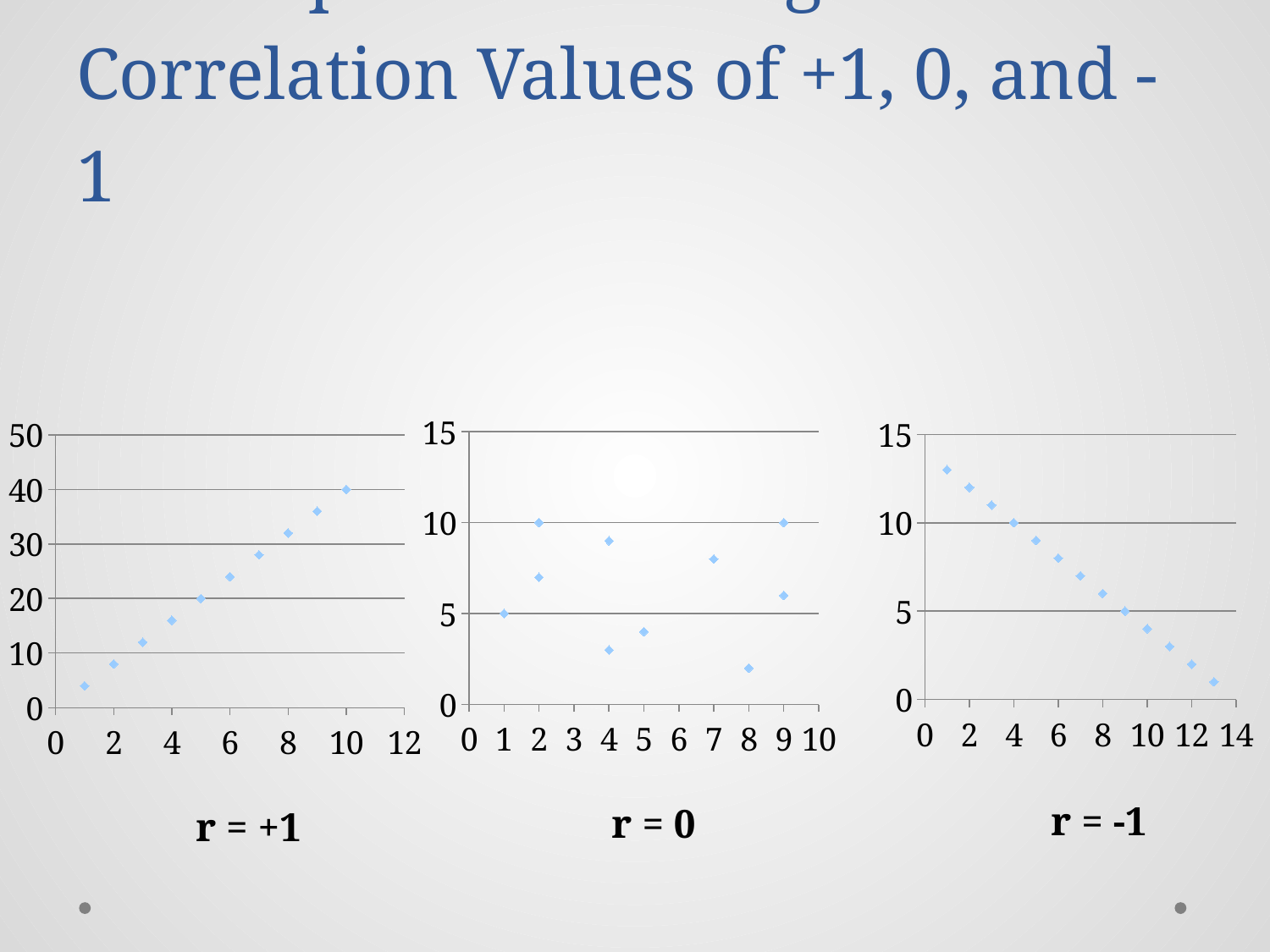
In the chart labelled r = -1, do the values rise or fall as x increases? fall In the chart labelled r = -1, is the y value of the point at x = 1 greater or less than 10? greater In the chart labelled r = +1, what is the y value of the point at x = 5? 20 How many points are plotted in the chart labelled r = +1? 10 What kind of chart is the one labelled r = +1? scatter chart In the chart labelled r = 0, what is the y value of the point at x = 1? 5 In the chart labelled r = +1, is the y value of the point at x = 2 greater or less than 10? less In the chart labelled r = -1, what is the y value of the point at x = 4? 10 What is the highest value shown on the y axis of the chart labelled r = +1? 50 In the chart labelled r = +1, do the values rise or fall as x increases? rise How many points are plotted in the chart labelled r = -1? 13 In the chart labelled r = +1, what is the y value of the point at x = 10? 40